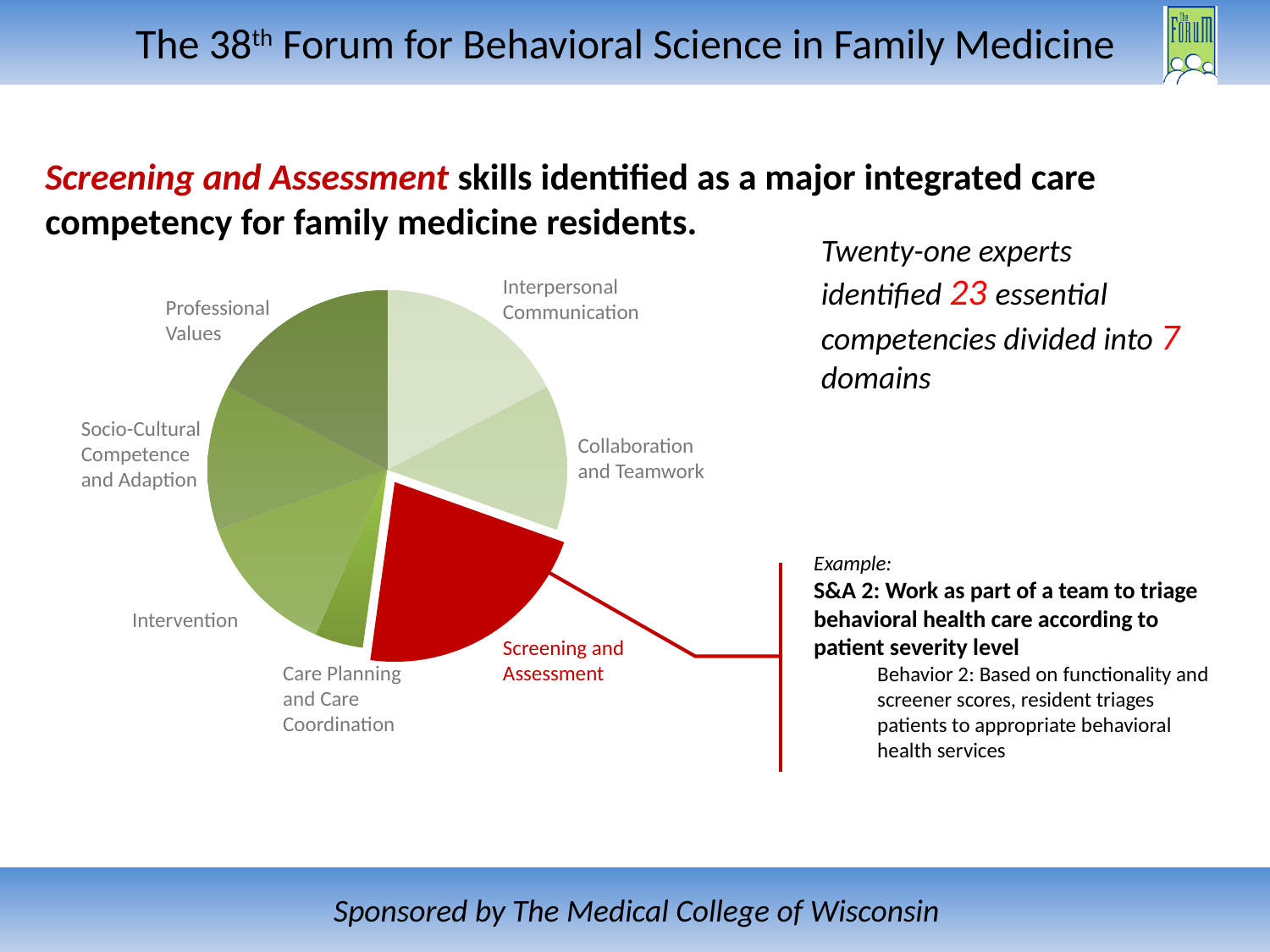
What colour is the Screening and Assessment slice? Red Which slice is larger: Care Planning and Care Coordination or Professional Values? Professional Values Which slice is larger: Care Planning and Care Coordination or Collaboration and Teamwork? Collaboration and Teamwork Which slice of the pie chart is pulled out (exploded) from the rest? Screening and Assessment What kind of chart is shown on the slide? Pie chart How many slices (domains) does the pie chart have? 7 Which slice of the pie chart is the smallest? Care Planning and Care Coordination Which slice is larger: Care Planning and Care Coordination or Interpersonal Communication? Interpersonal Communication